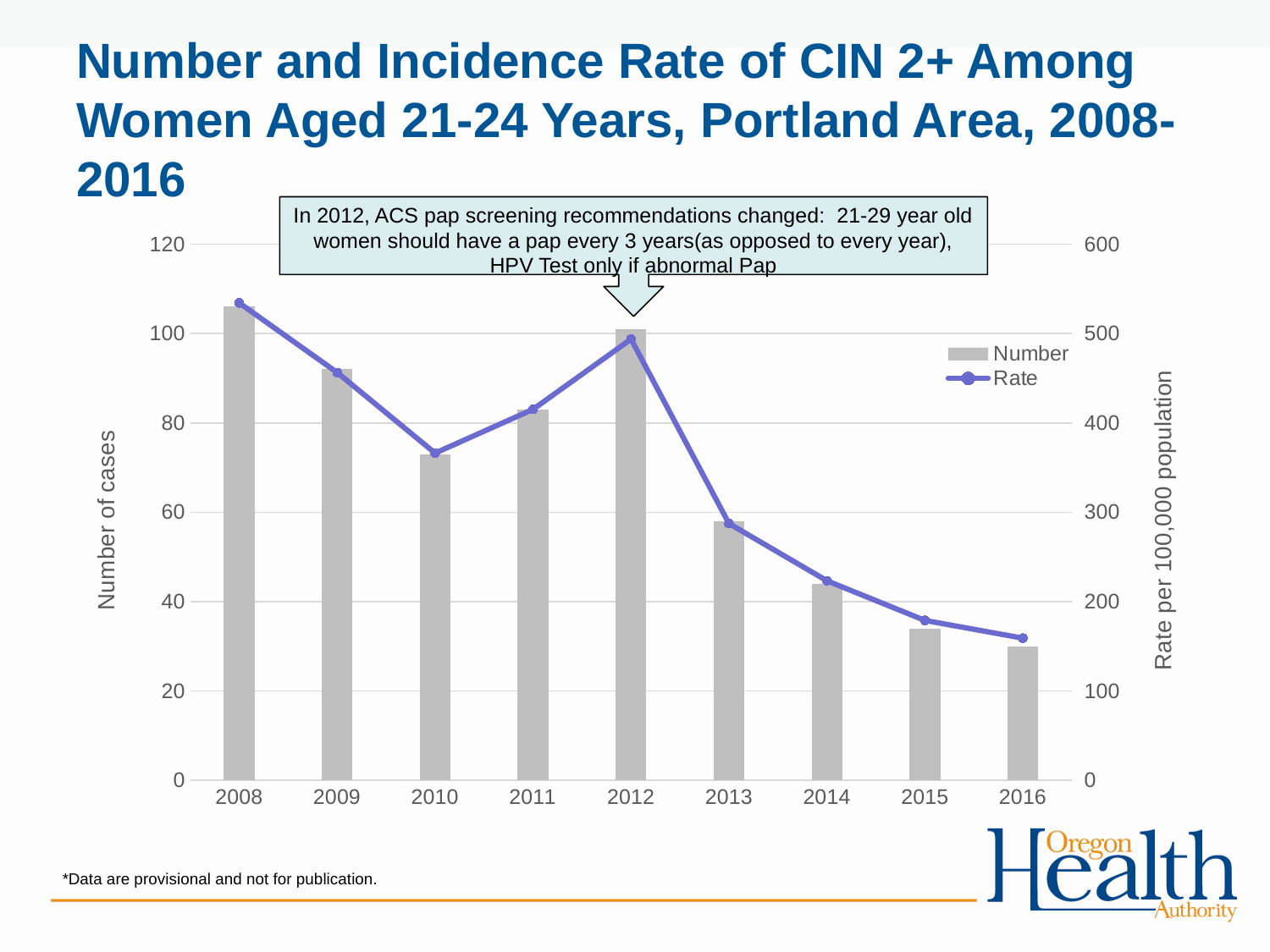
Do the number of cases rise or fall from 2012 to 2016? fall How many years are shown on the x axis? 9 Is the number of cases in 2010 greater or less than 80? less What kind of chart is shown on the slide? A combined bar and line chart Which year has the highest number of cases? 2008 Is the rate per 100,000 population in 2016 greater or less than 200? less Is the number of cases in 2008 greater or less than 100? greater Which year has a higher number of cases, 2011 or 2013? 2011 How many series does the legend list? 2 What does the right-hand vertical axis measure? Rate per 100,000 population Which year has the lowest number of cases? 2016